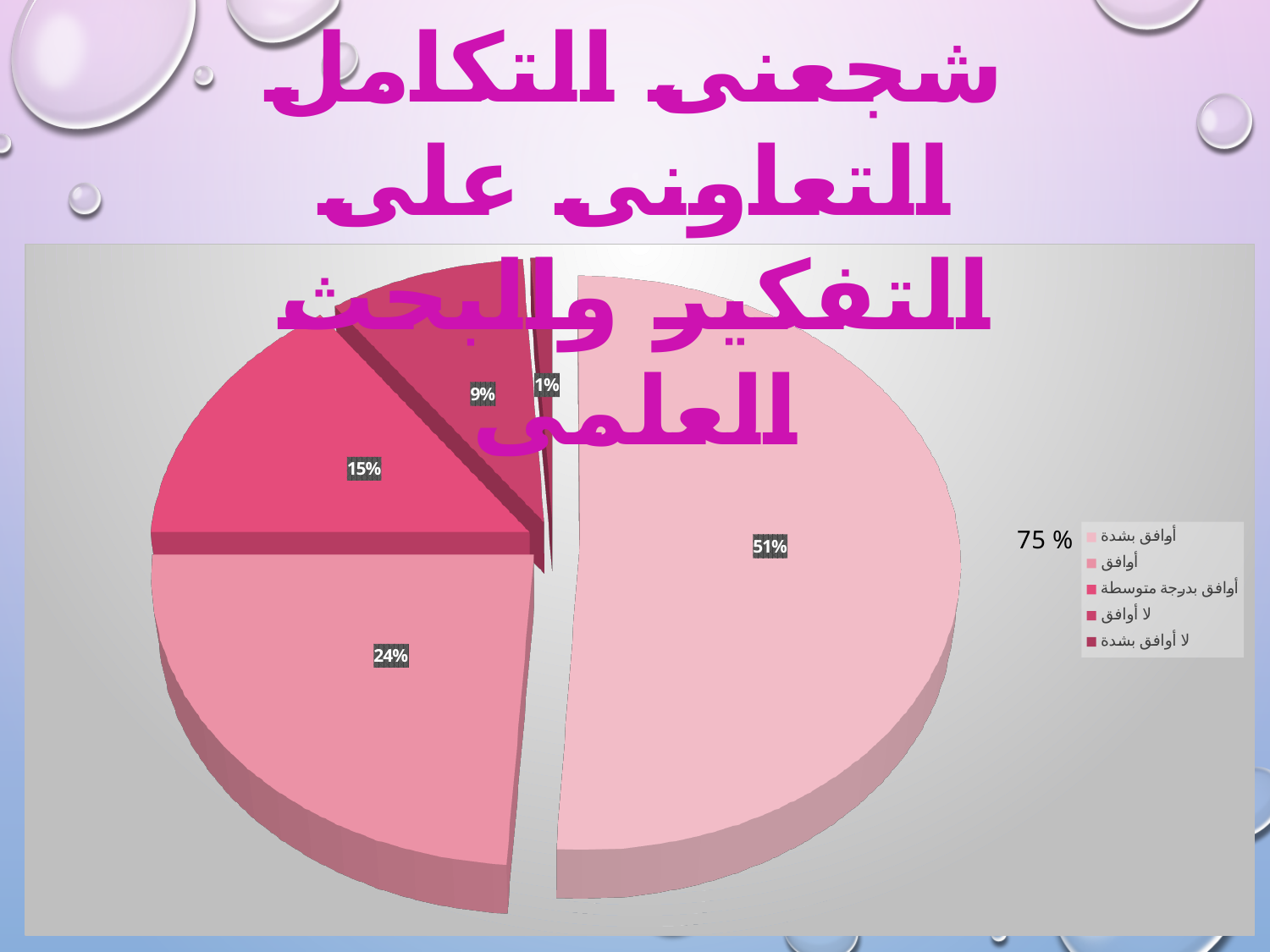
Which slice is larger, أوافق بدرجة متوسطة or لا أوافق? أوافق بدرجة متوسطة What percentage of the pie is labelled for أوافق بشدة? 51% What percentage of the pie is labelled for أوافق? 24% What percentage of the pie is labelled for لا أوافق بشدة? 1% How many categories does the legend list? 5 What is the difference in percentage points between the أوافق بشدة slice and the أوافق slice? 27 What percentage of the pie is labelled for لا أوافق? 9% Which category has the smallest slice of the pie? لا أوافق بشدة Which category has the largest slice of the pie? أوافق بشدة What is the combined share of the أوافق بشدة and أوافق slices? 75% What percentage of the pie is labelled for أوافق بدرجة متوسطة? 15% What kind of chart is shown on the slide? pie chart